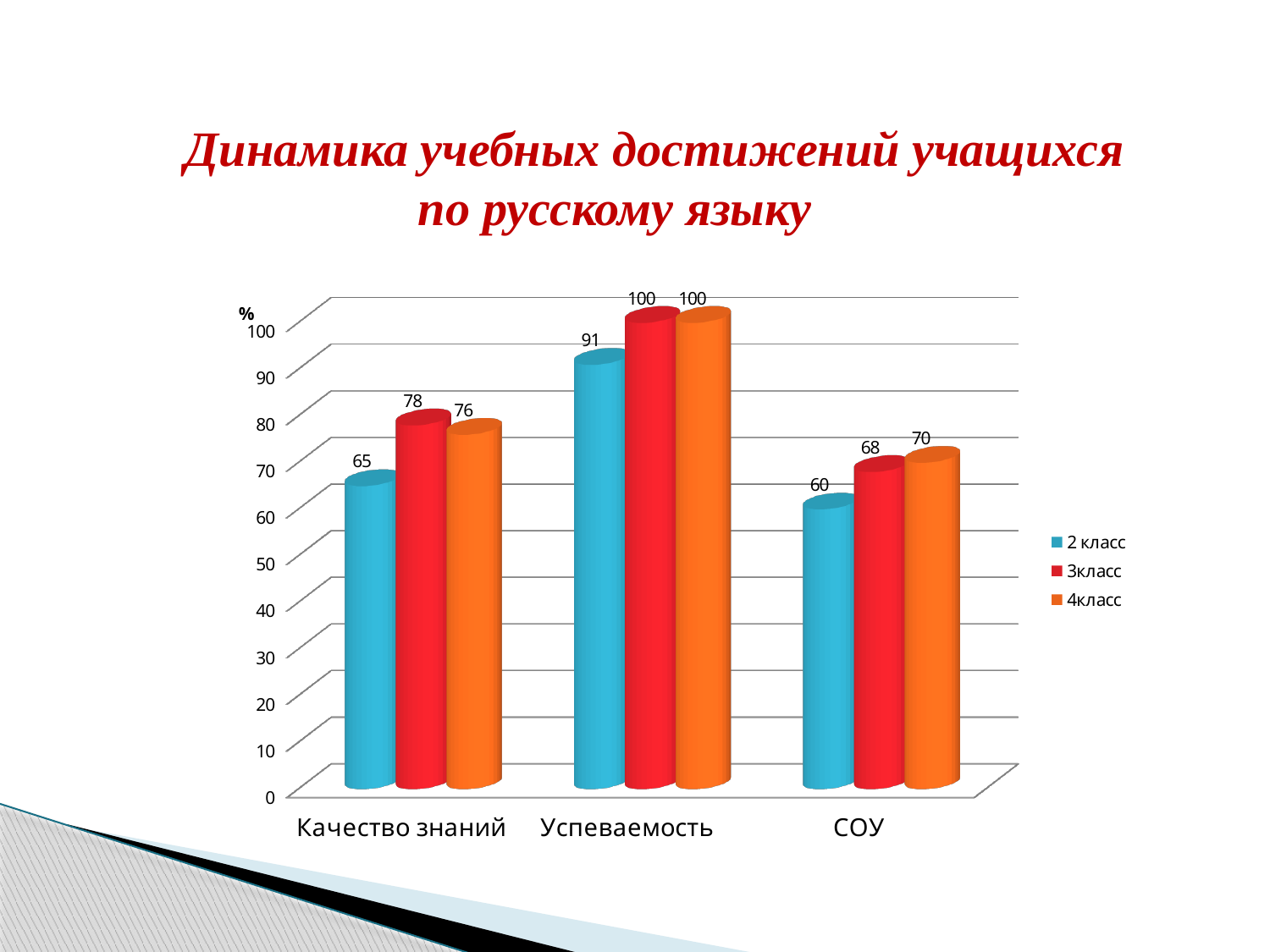
What is the value for 4класс in the СОУ category? 70 What is the difference between the 3класс and 2 класс values in the Качество знаний category? 13 Which category has the lowest value for 4класс? СОУ What is the value for 2 класс in the Качество знаний category? 65 What unit is shown on the vertical axis of the chart? % Is the value for 2 класс in the Успеваемость category greater or less than 80? greater What kind of chart is shown on the slide? bar chart Which category has the highest value for 2 класс? Успеваемость How many categories are shown on the x axis? 3 Which is larger in the СОУ category: the value for 3класс or for 4класс? 4класс What is the value for 3класс in the Успеваемость category? 100 How many series does the legend list? 3